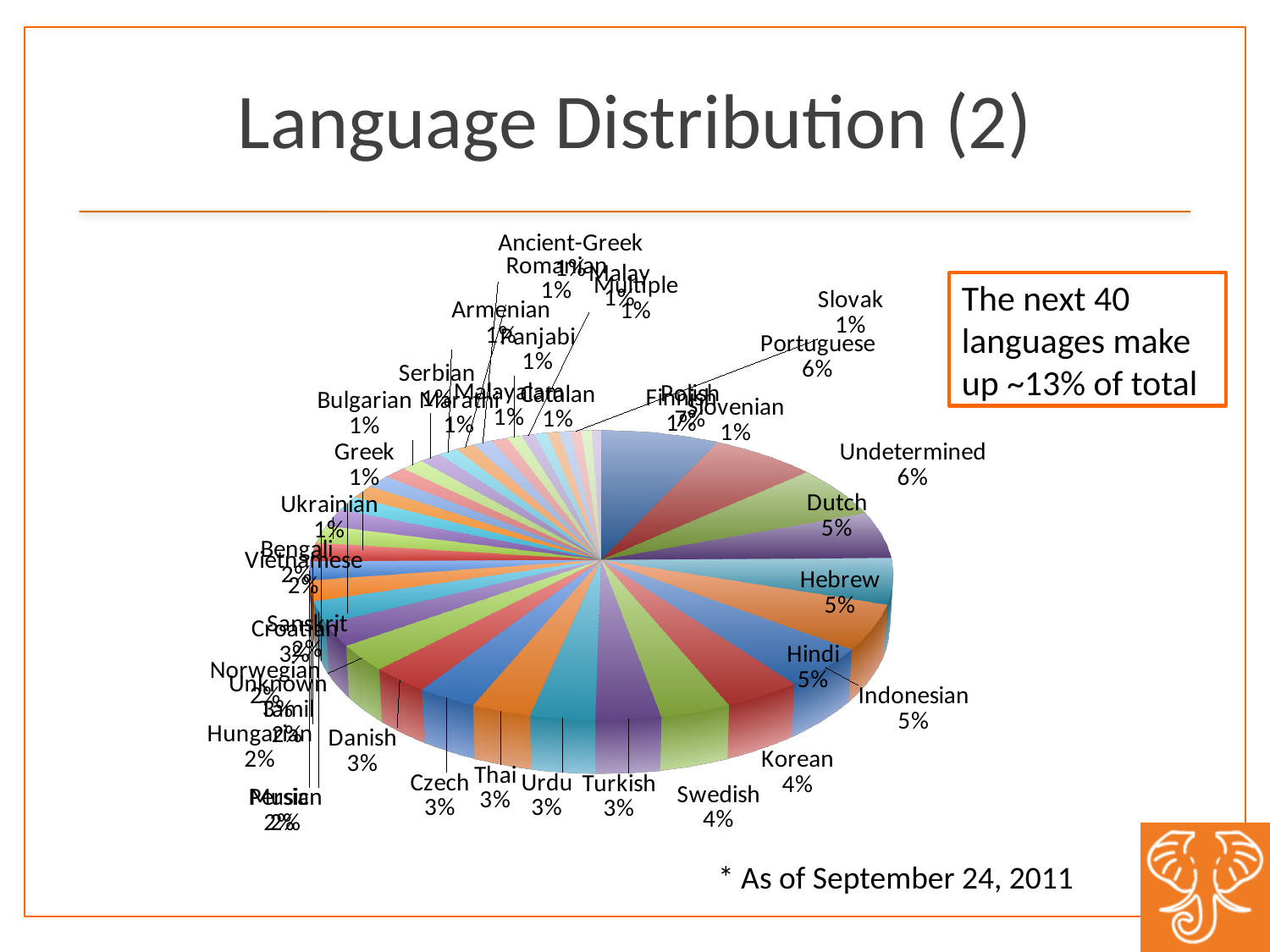
What percentage is shown for Undetermined? 6% What is the difference between the shares of Portuguese and Korean? 2% What is the title of the slide containing the pie chart? Language Distribution (2) What percentage is shown for Slovak? 1% What percentage is shown for Hungarian? 2% What percentage is shown for Swedish? 4% What share of the pie does Portuguese account for? 6% Which has the larger share, Hebrew or Czech? Hebrew What percentage is shown for Dutch? 5% What kind of chart is shown on the slide? pie chart What is the value shown for Turkish? 3% What is the value shown for Korean? 4%